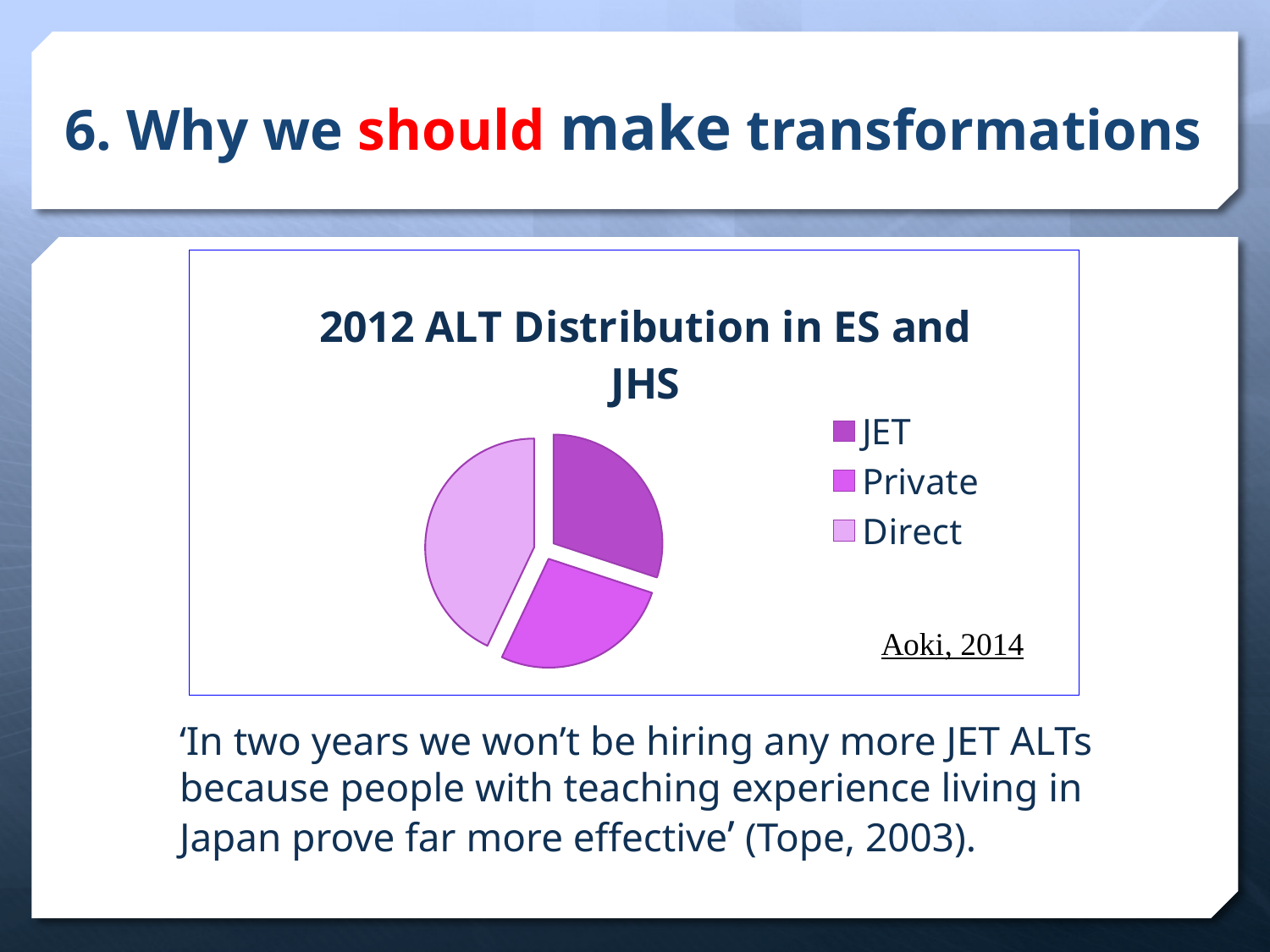
Which category has the largest slice in the pie chart? Direct What kind of chart is shown on the slide? Pie chart How many entries does the legend of the pie chart list? 3 Is the Direct slice greater or less than a quarter of the pie? greater Which slice is larger, Direct or JET? Direct How many slices does the pie chart have? 3 Which slice is larger, Direct or Private? Direct What is the title of the pie chart? 2012 ALT Distribution in ES and JHS Which categories are listed in the legend of the pie chart? JET, Private, Direct